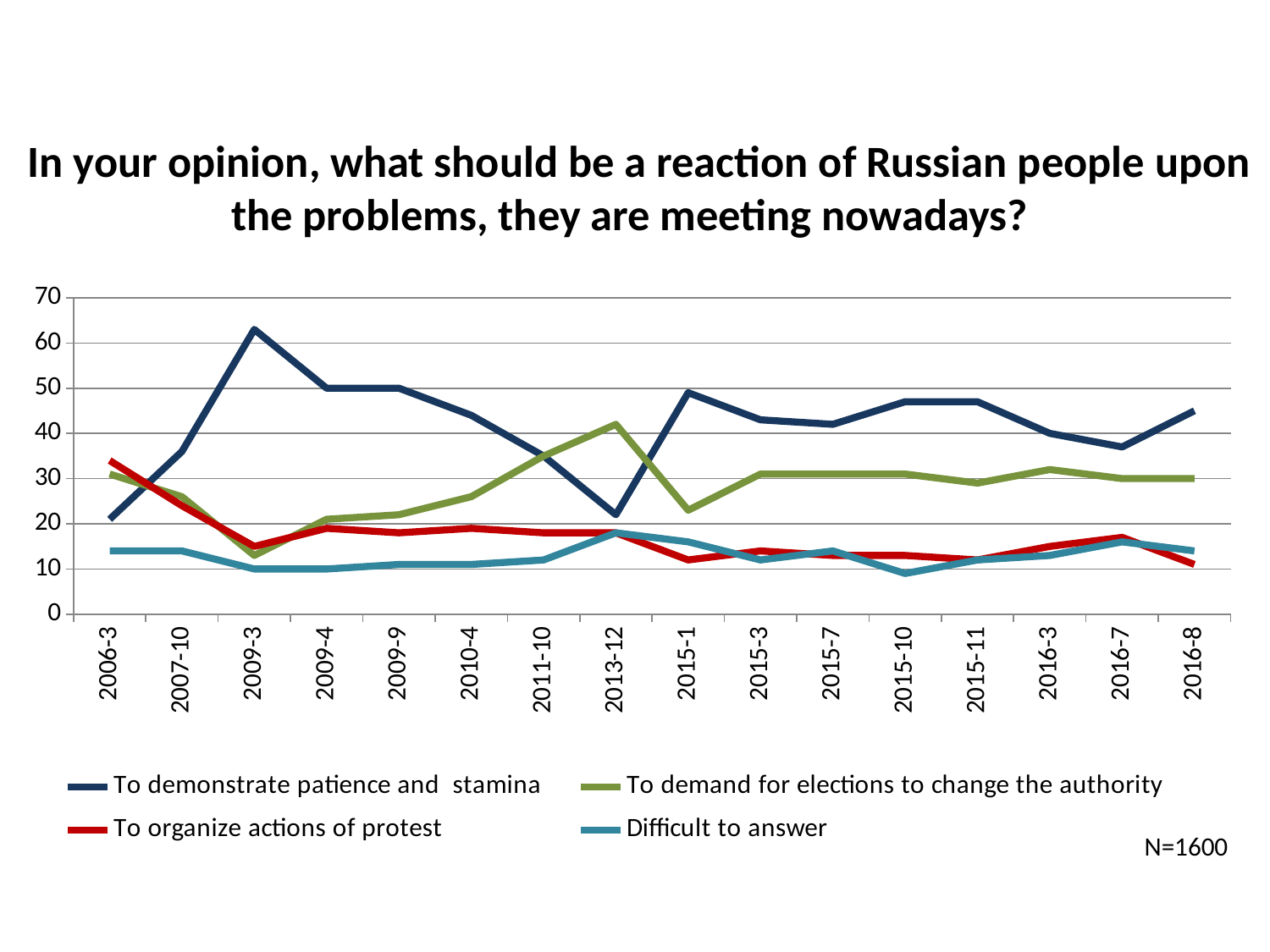
What kind of chart is shown on the slide? Line chart Is the value for 'To demonstrate patience and stamina' at 2009-3 greater or less than 60? greater At which date does the 'To demonstrate patience and stamina' line reach its highest value? 2009-3 At which date does the 'To demand for elections to change the authority' line reach its lowest value? 2009-3 How many series does the legend list? 4 Does the 'To demonstrate patience and stamina' line rise or fall between 2009-3 and 2013-12? Fall How many survey dates are shown along the x axis? 16 Is the value for 'To demonstrate patience and stamina' at 2013-12 greater or less than 30? less At 2013-12, which is larger: 'To demand for elections to change the authority' or 'To demonstrate patience and stamina'? To demand for elections to change the authority At which date does the 'To demand for elections to change the authority' line reach its highest value? 2013-12 What sample size (N) is stated on the slide? N=1600